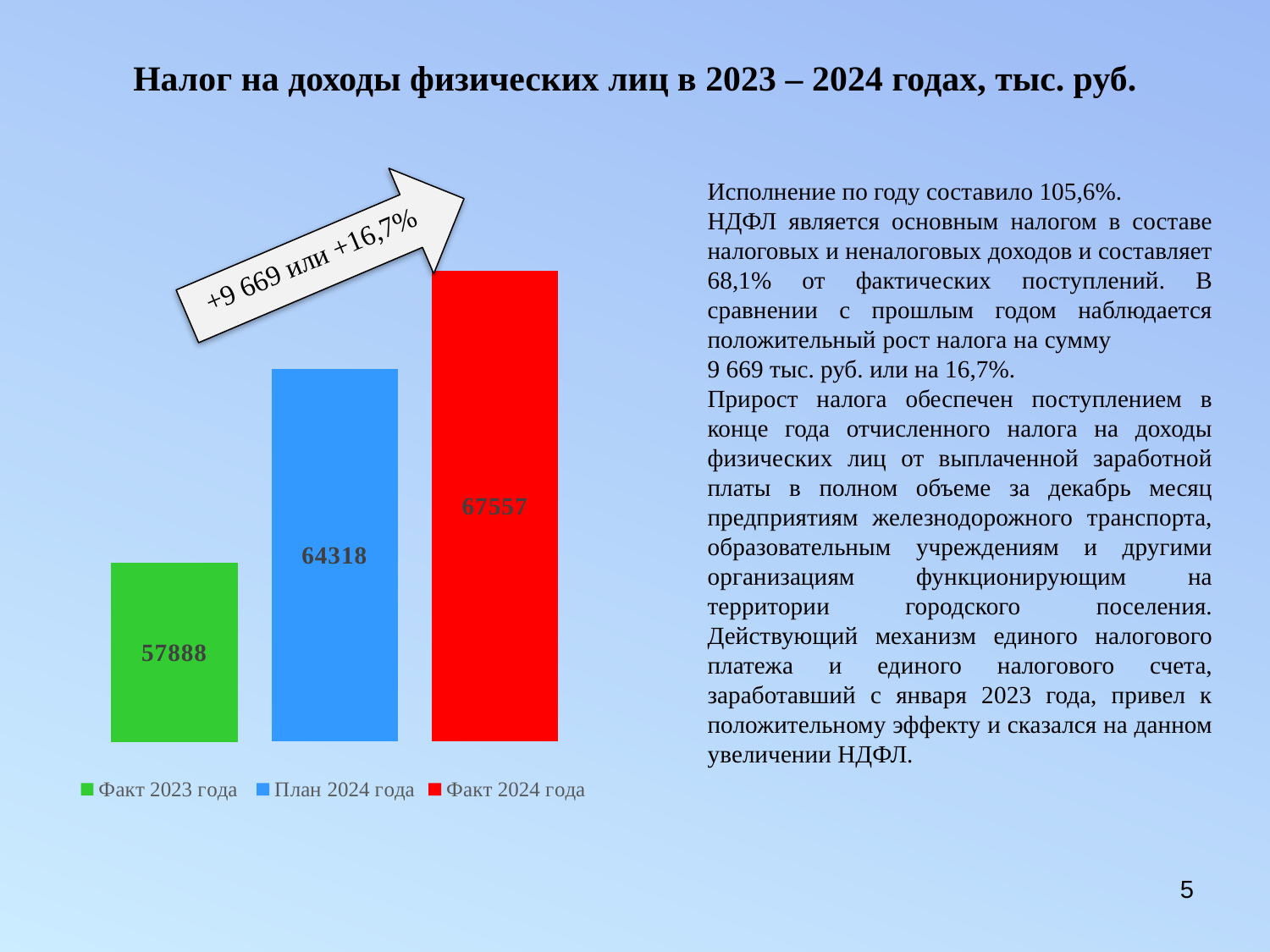
What is the difference between План 2024 года and Факт 2023 года? 6430 What is the value for Факт 2024 года? 67557 Which is larger, План 2024 года or Факт 2023 года? План 2024 года What is the difference between Факт 2024 года and План 2024 года? 3239 Which series has the highest value? Факт 2024 года What is the title of the chart? Налог на доходы физических лиц в 2023 – 2024 годах, тыс. руб. What is the value for План 2024 года? 64318 What is the difference between Факт 2024 года and Факт 2023 года? 9669 What kind of chart is shown on the slide? bar chart Which series has the lowest value? Факт 2023 года How many series does the legend list? 3 What is the value for Факт 2023 года? 57888